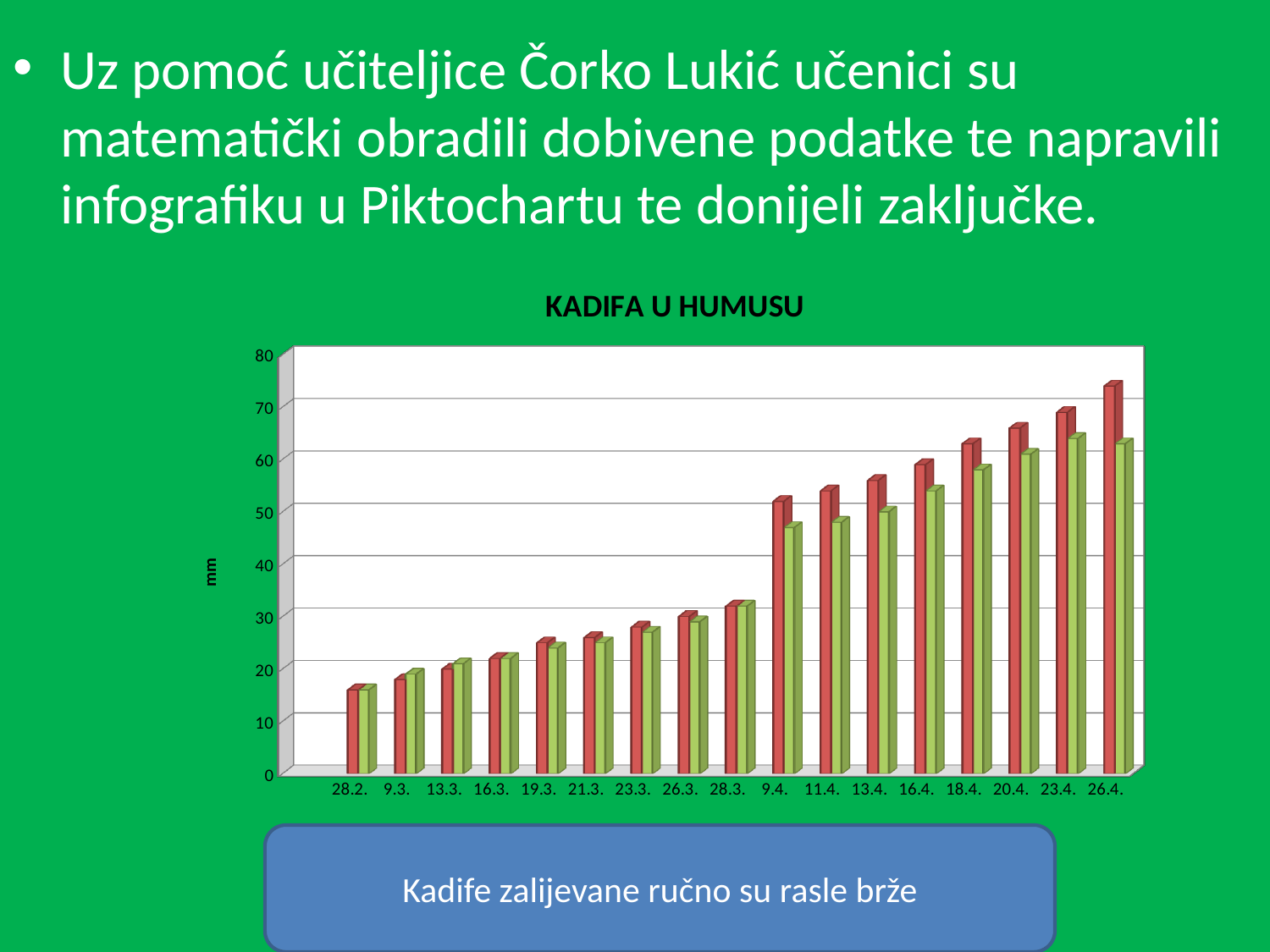
On which date is the red bar the shortest? 28.2. Do the values in the chart rise or fall from 28.2. to 26.4.? rise What is the title of the chart? KADIFA U HUMUSU Is the value of the green bar for 26.4. greater or less than 60? greater On which date is the red bar the tallest? 26.4. Is the value of the green bar for 9.4. greater or less than 50? less Is the value of the red bar for 26.4. greater or less than 70? greater For 26.4., which bar is taller, the red one or the green one? the red one What kind of chart is shown on the slide? bar chart How many dates (categories) are shown along the x axis of the chart? 17 What is the label on the vertical axis of the chart? mm